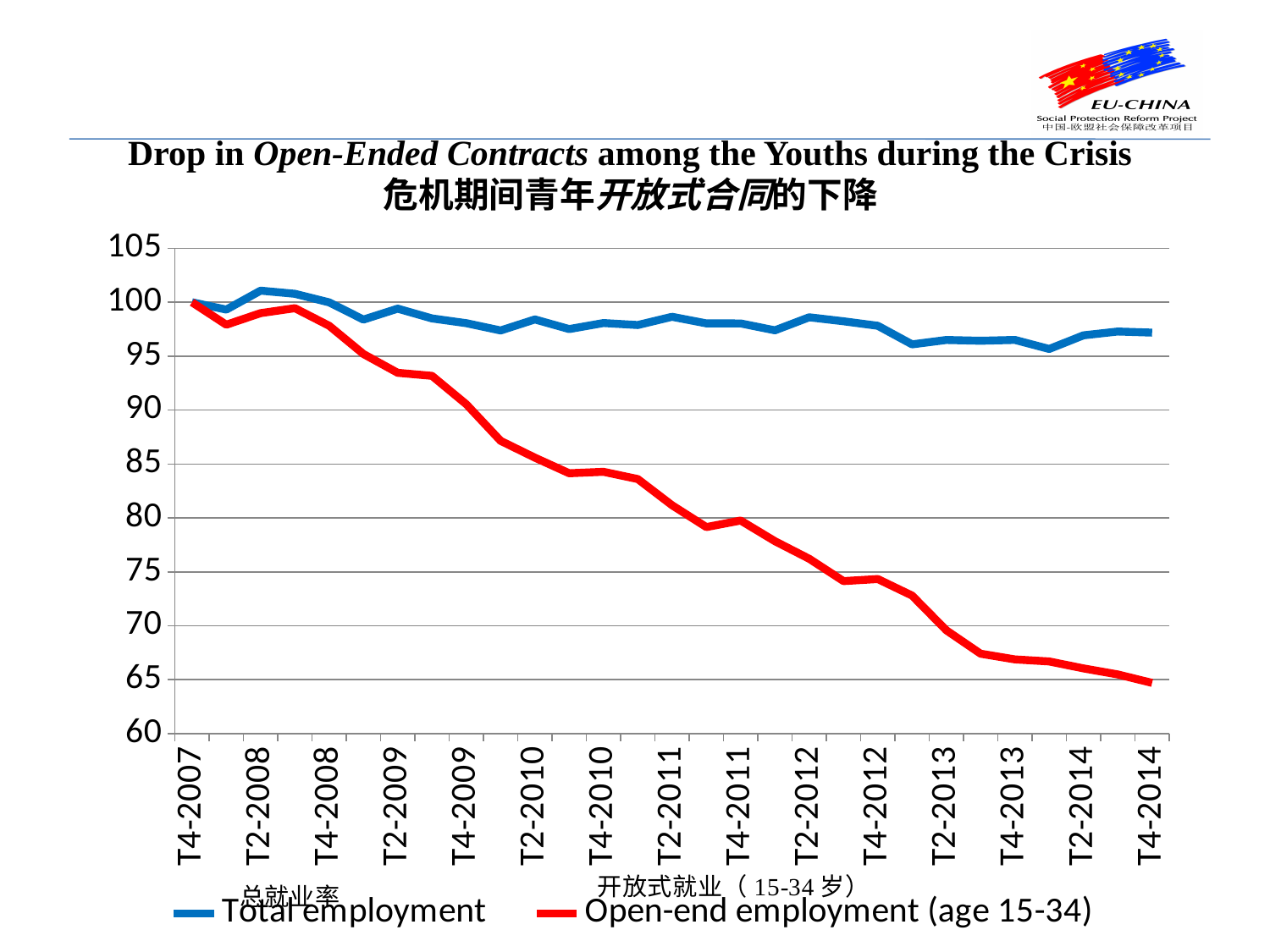
At T4-2014, which series has the higher value, Total employment or Open-end employment (age 15-34)? Total employment In which period does the Open-end employment (age 15-34) series reach its highest value? T4-2007 Does the Open-end employment (age 15-34) series rise or fall from T4-2007 to T4-2014? fall Is the value of Open-end employment (age 15-34) at T4-2014 greater or less than 70? less What is the first period shown on the x axis? T4-2007 How many series does the legend list? 2 What kind of chart is shown on the slide? line chart In which period does the Open-end employment (age 15-34) series reach its lowest value? T4-2014 Is the value of Open-end employment (age 15-34) at T4-2012 greater or less than 80? less Which series is drawn in red? Open-end employment (age 15-34) Is the value of Total employment at T4-2014 greater or less than 95? greater